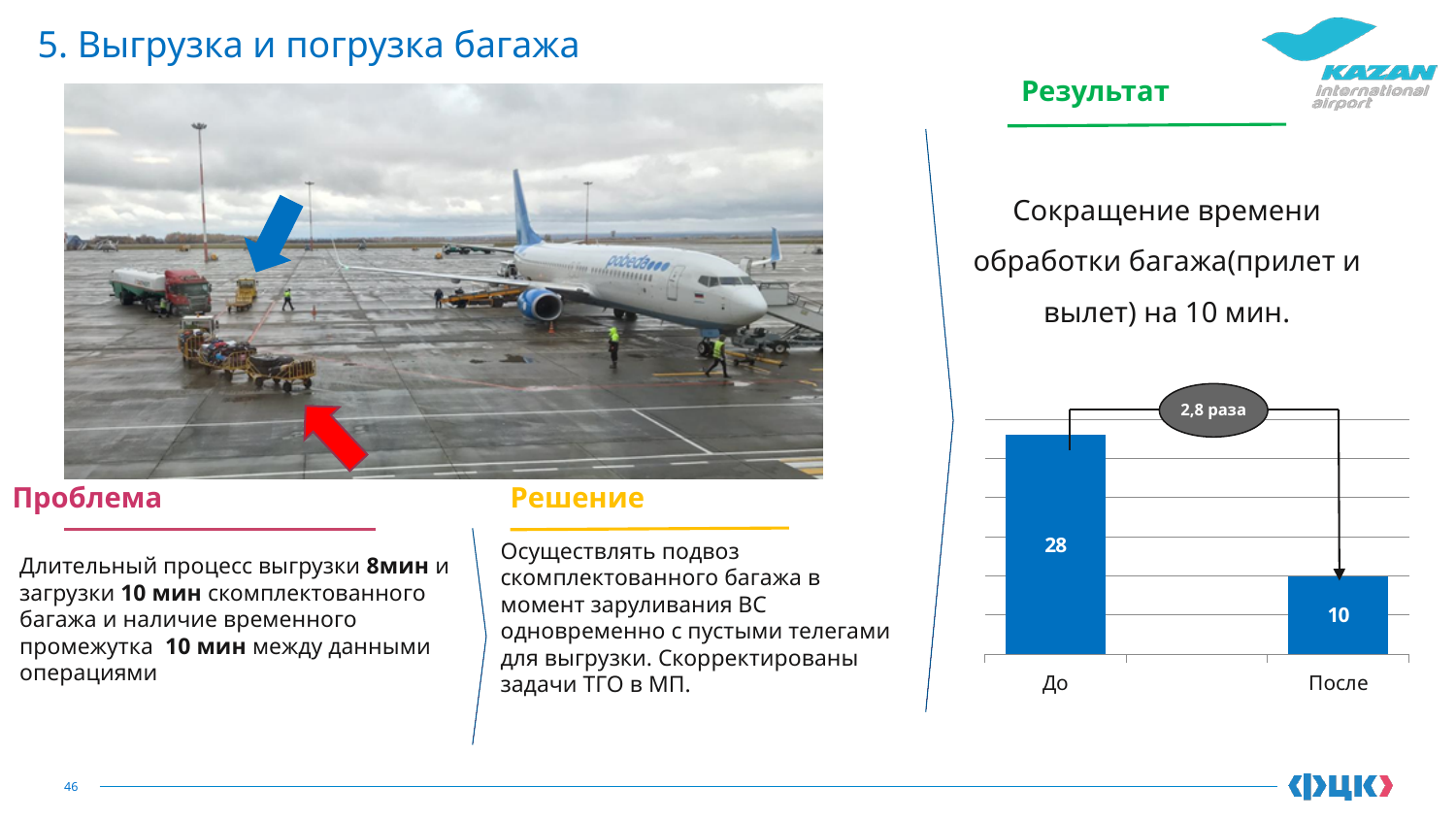
Do the values rise or fall from "До" to "После"? Fall What is the difference between the values for "До" and "После"? 18 What is the value for "После" in the chart? 10 What colour are the bars in the chart? Blue Which category has the highest value in the chart? До Which is larger, the value for "До" or the value for "После"? До What ratio is written in the oval annotation above the bars? 2,8 раза What kind of chart is shown on the slide? Bar chart What is the value for "До" in the chart? 28 Which category has the lowest value in the chart? После How many categories are shown in the chart? 2